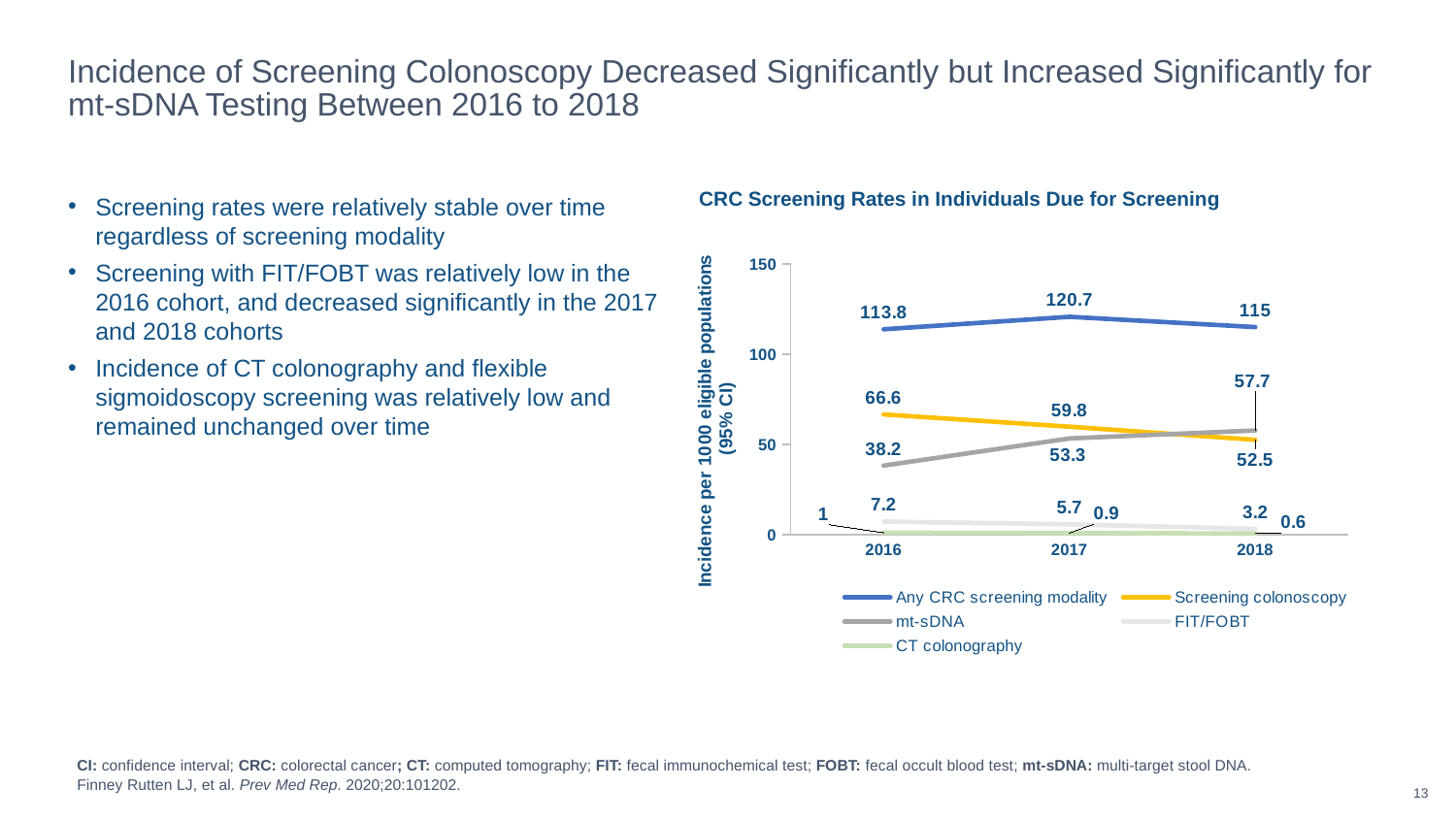
What is the title of the chart? CRC Screening Rates in Individuals Due for Screening Does the Screening colonoscopy value rise or fall from 2016 to 2018? fall What is the value for Any CRC screening modality in 2017? 120.7 What kind of chart is shown? line chart What is the value for FIT/FOBT in 2017? 5.7 What is the value for Screening colonoscopy in 2016? 66.6 In which year is the Any CRC screening modality value highest? 2017 In which year is the Screening colonoscopy value lowest? 2018 Which is larger in 2018, the value for mt-sDNA or the value for Screening colonoscopy? mt-sDNA What is the difference between the Screening colonoscopy values in 2016 and 2018? 14.1 How many series does the legend list? 5 What is the value for mt-sDNA in 2018? 57.7